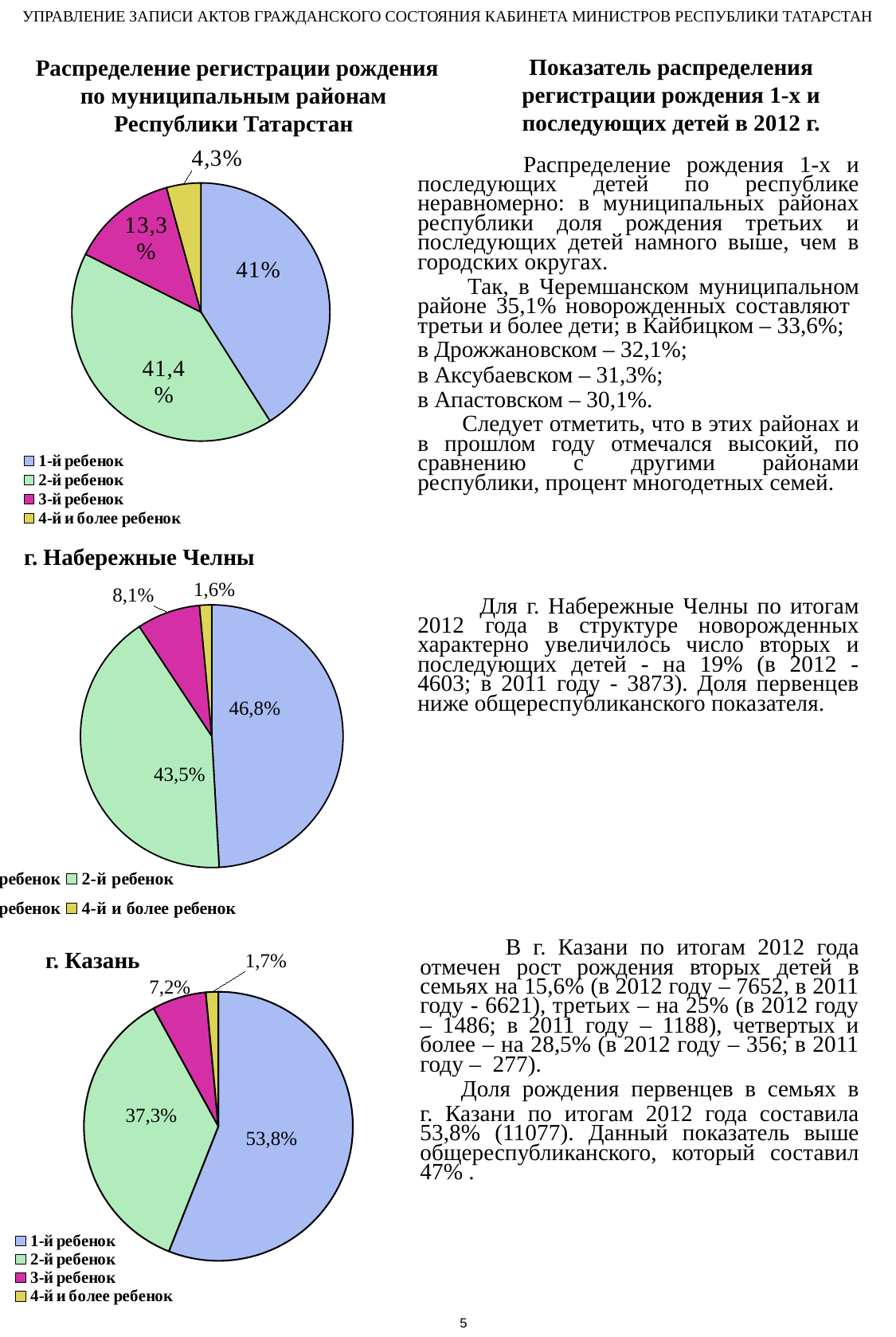
In the top pie chart (Распределение регистрации рождения по муниципальным районам Республики Татарстан), which category has the smallest share? 4-й и более ребенок In the pie chart for г. Набережные Челны, what share is shown for 1-й ребенок? 46,8% In the pie chart for г. Казань, which is larger: the share for 3-й ребенок or the share for 4-й и более ребенок? 3-й ребенок In the pie chart for г. Казань, which category has the largest share? 1-й ребенок In the pie chart for г. Казань, what share is shown for 1-й ребенок? 53,8% In the pie chart for г. Казань, what is the difference between the shares for 1-й ребенок and 2-й ребенок? 16,5% In the top pie chart (Распределение регистрации рождения по муниципальным районам Республики Татарстан), what share is shown for 4-й и более ребенок? 4,3% How many slices does the pie chart for г. Казань have? 4 In the pie chart for г. Набережные Челны, what is the difference between the shares for 3-й ребенок and 4-й и более ребенок? 6,5% In the top pie chart (Распределение регистрации рождения по муниципальным районам Республики Татарстан), what share is shown for 3-й ребенок? 13,3% What type of chart is used for г. Набережные Челны? Pie chart In the pie chart for г. Набережные Челны, what share is shown for 2-й ребенок? 43,5%